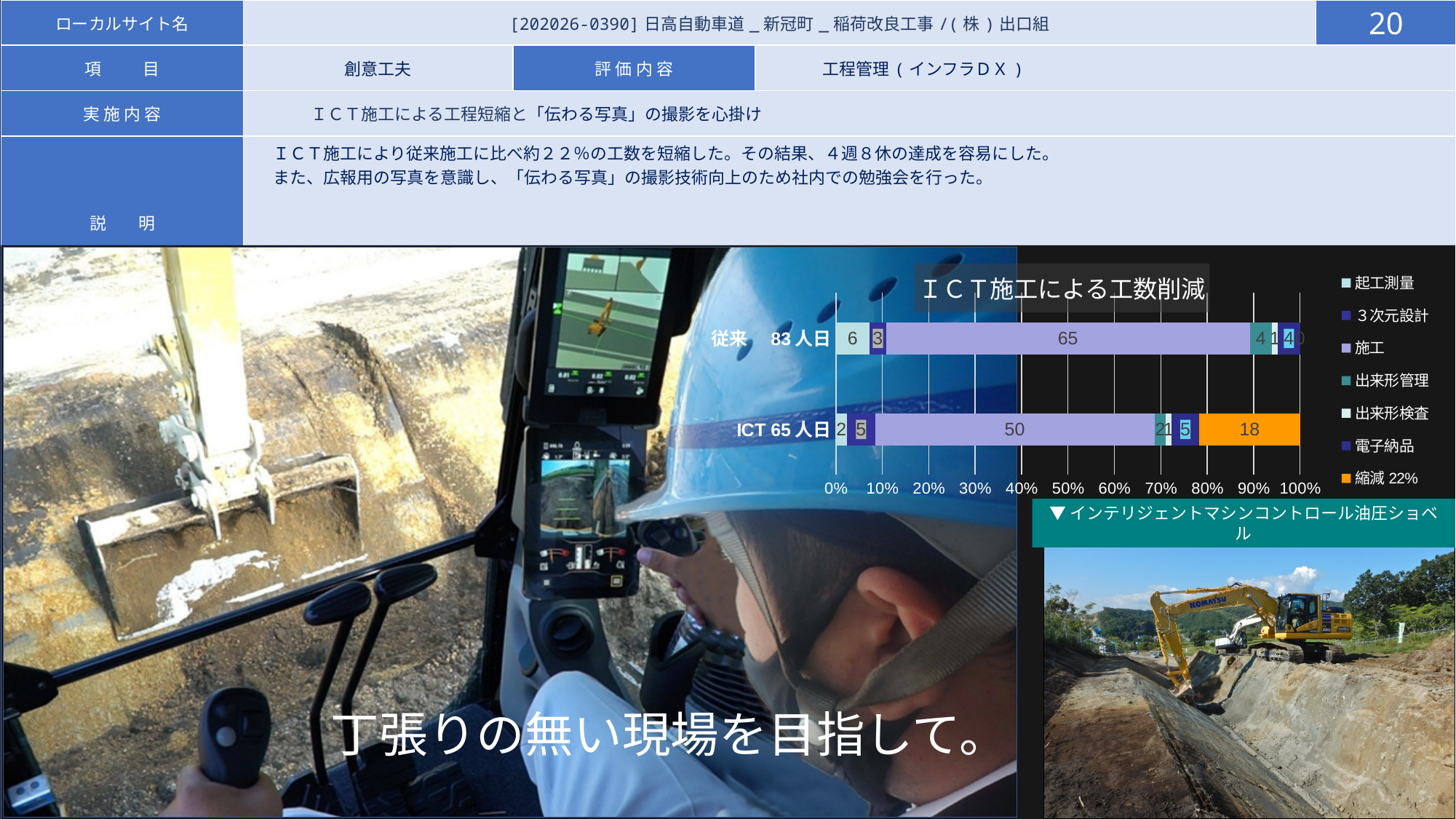
How many series does the chart legend list? 7 What is the value of 施工 for the ICT bar? 50 What is the difference between the 施工 values of the 従来 bar and the ICT bar? 15 How many categories (bars) does the chart show? 2 What is the last entry listed in the chart legend? 縮減 22% What is the value of 電子納品 for the ICT bar? 5 What kind of chart is shown on the slide? bar chart What is the value of the 縮減 22% segment in the ICT bar? 18 What is the title of the chart? ＩＣＴ施工による工数削減 What is the value of 起工測量 for the 従来 bar? 6 Which bar has the larger 起工測量 value, 従来 or ICT? 従来 What is the value of 施工 for the 従来 bar? 65